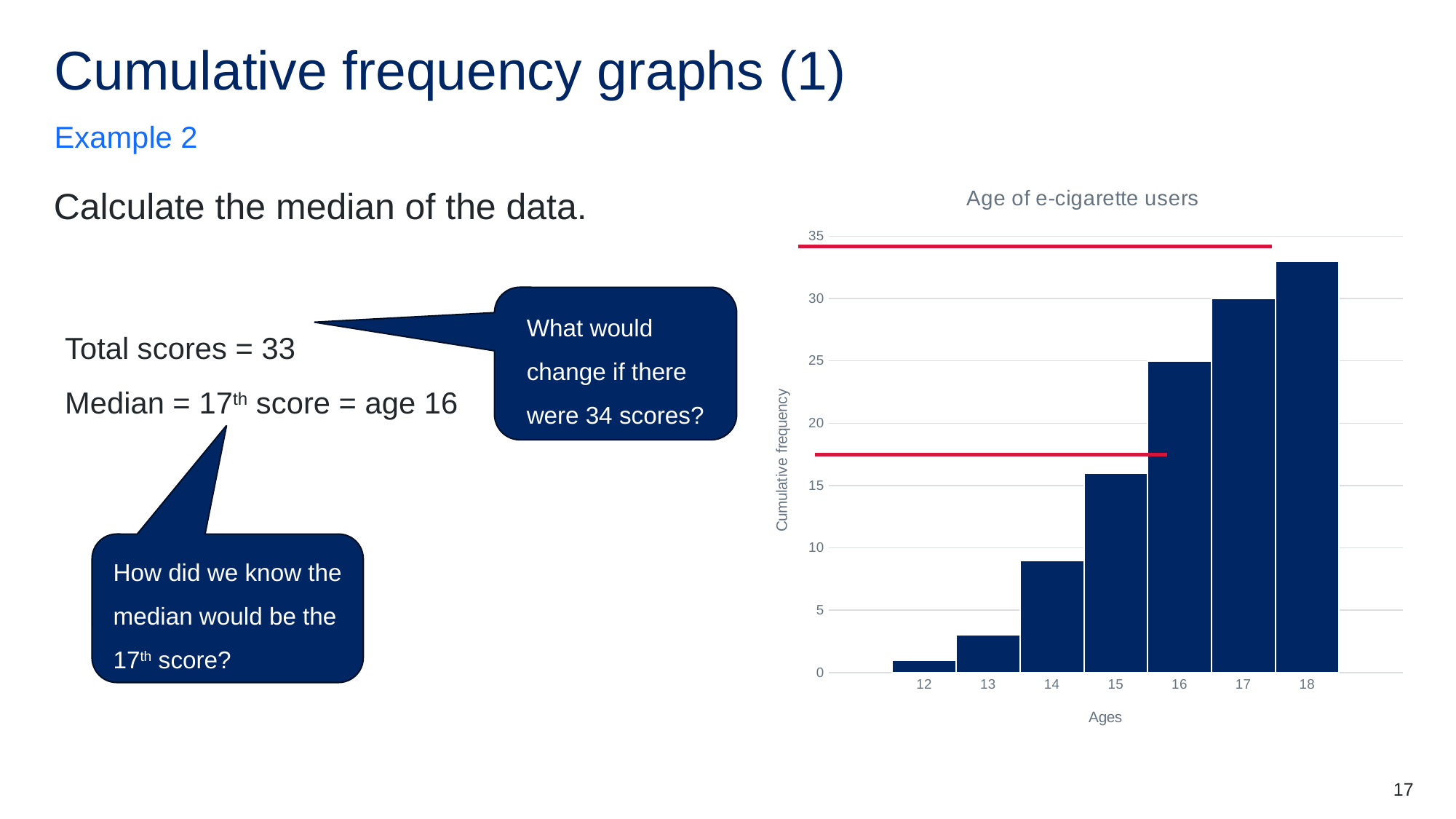
Do the cumulative frequency values rise or fall as age increases along the x axis? rise Which age has the lowest cumulative frequency? 12 What is the cumulative frequency for age 17? 30 What is the title of the chart? Age of e-cigarette users Which has the larger cumulative frequency, age 15 or age 16? 16 Which age has the highest cumulative frequency? 18 How many age categories are plotted on the x axis? 7 What is the label on the vertical axis of the chart? Cumulative frequency Is the cumulative frequency for age 18 greater or less than 30? greater What is the cumulative frequency for age 16? 25 Is the cumulative frequency for age 14 greater or less than 10? less What kind of chart is shown on the slide? bar chart